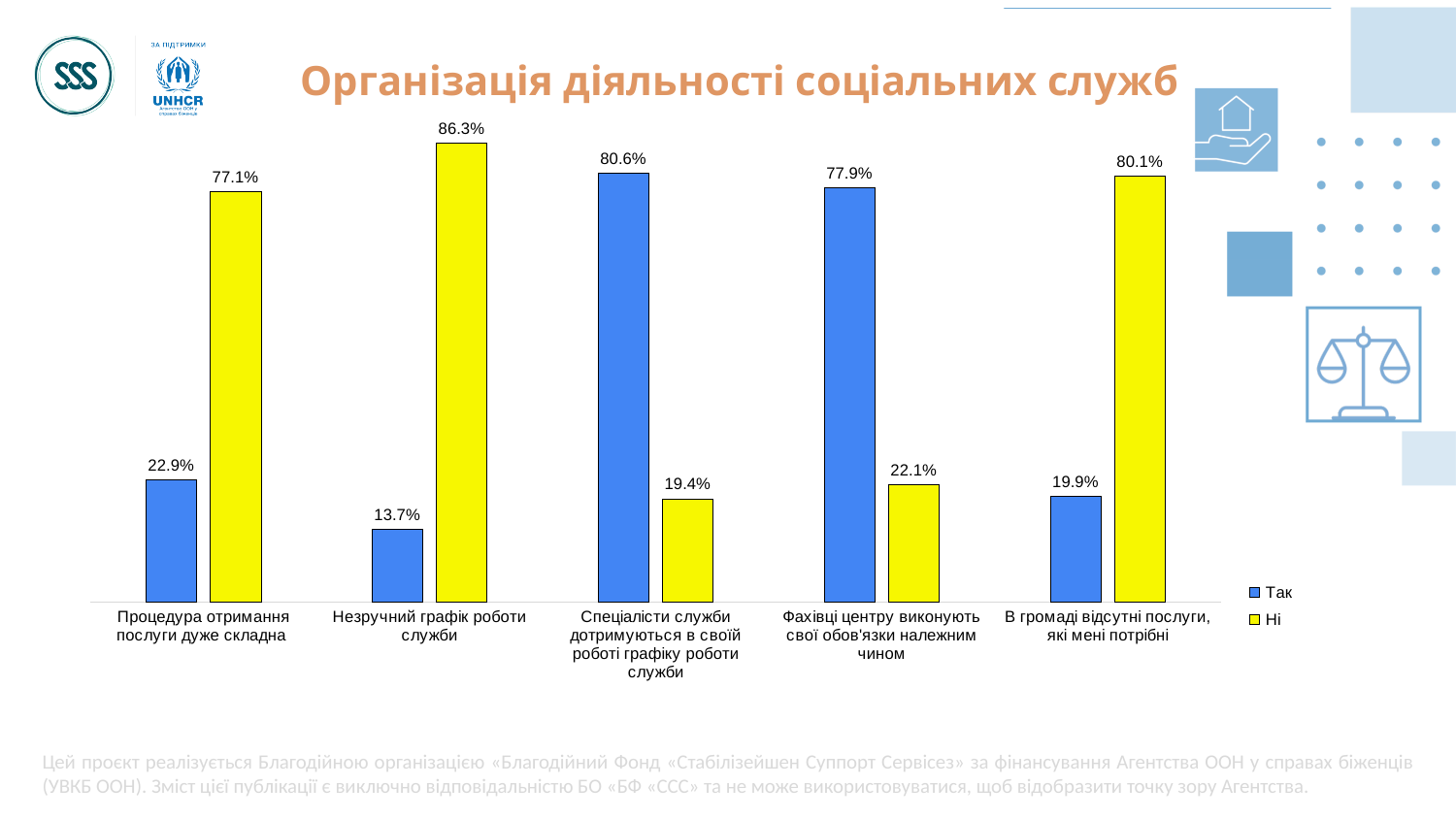
Which category has the highest "Ні" value? Незручний графік роботи служби What is the title of the chart? Організація діяльності соціальних служб For "В громаді відсутні послуги, які мені потрібні", which is larger: "Так" or "Ні"? Ні How many series does the legend list? 2 What is the value of "Ні" for "Незручний графік роботи служби"? 86.3% How many categories are shown on the x axis? 5 What is the value of "Так" for "Процедура отримання послуги дуже складна"? 22.9% What is the value of "Ні" for "В громаді відсутні послуги, які мені потрібні"? 80.1% What type of chart is shown on the slide? bar chart What is the value of "Так" for "Спеціалісти служби дотримуються в своїй роботі графіку роботи служби"? 80.6% Which category has the lowest "Так" value? Незручний графік роботи служби What is the difference between the "Ні" and "Так" values for "Фахівці центру виконують свої обов'язки належним чином"? 55.8%